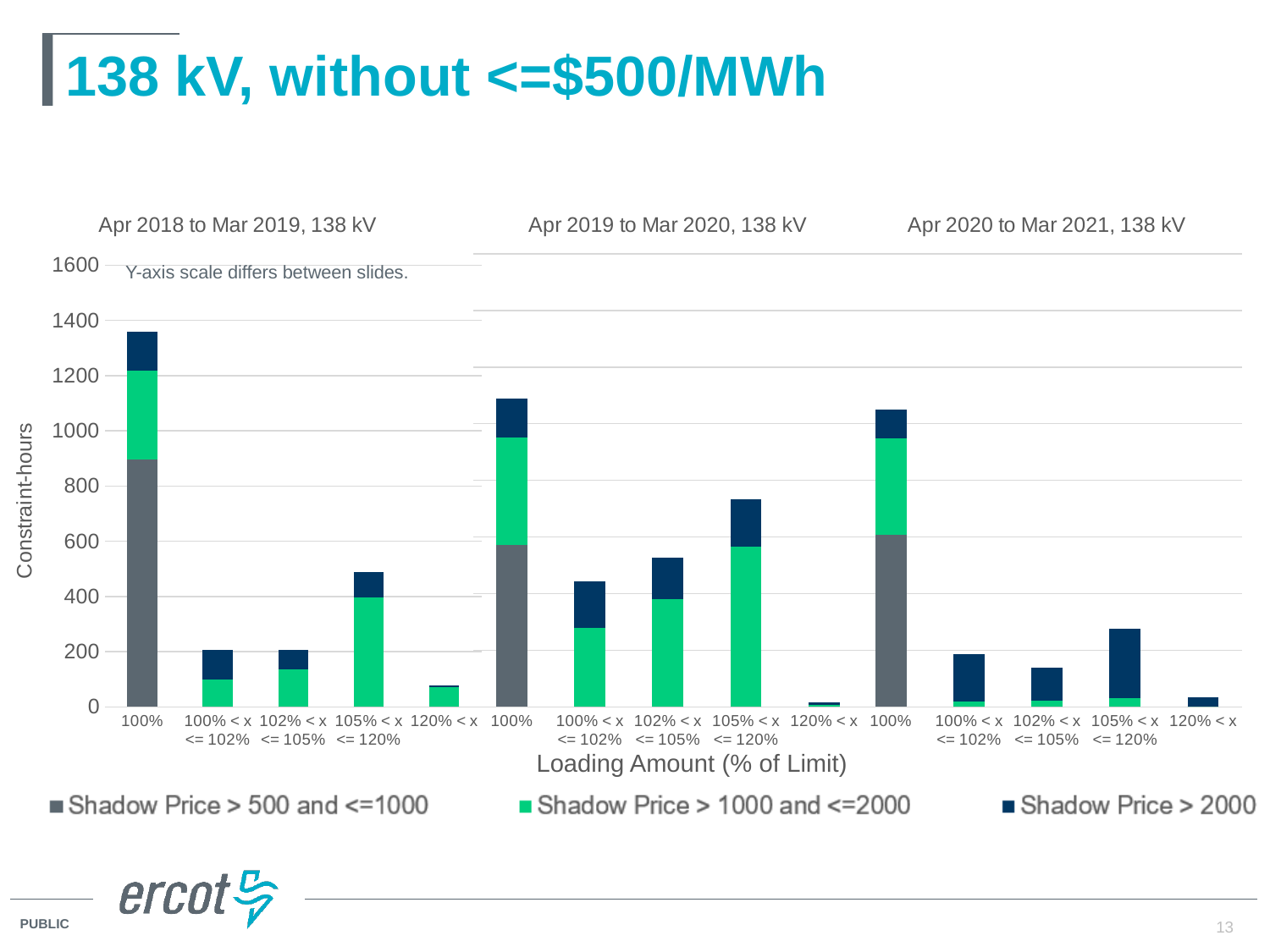
Is the total value for the 120% < x bar in the Apr 2018 to Mar 2019, 138 kV panel greater or less than 200? less Is the total value for the 100% bar in the Apr 2018 to Mar 2019, 138 kV panel greater or less than 1200? greater How many loading-amount categories are plotted in the Apr 2019 to Mar 2020, 138 kV panel? 5 Which bar is the tallest across the whole chart? 100% in Apr 2018 to Mar 2019, 138 kV Which is larger: the 100% bar in the Apr 2018 to Mar 2019 panel or the 100% bar in the Apr 2019 to Mar 2020 panel? Apr 2018 to Mar 2019 How many bars are plotted across all three panels of the chart? 15 What kind of chart is shown on the slide? Stacked bar chart What is the label on the y-axis of the chart? Constraint-hours Which legend entry is shown in green? Shadow Price > 1000 and <=2000 Within the Apr 2019 to Mar 2020, 138 kV panel, which loading-amount category has the lowest total constraint-hours? 120% < x Is the total value for the 105% < x <= 120% bar in the Apr 2019 to Mar 2020, 138 kV panel greater or less than 600? greater How many series does the chart legend list? 3